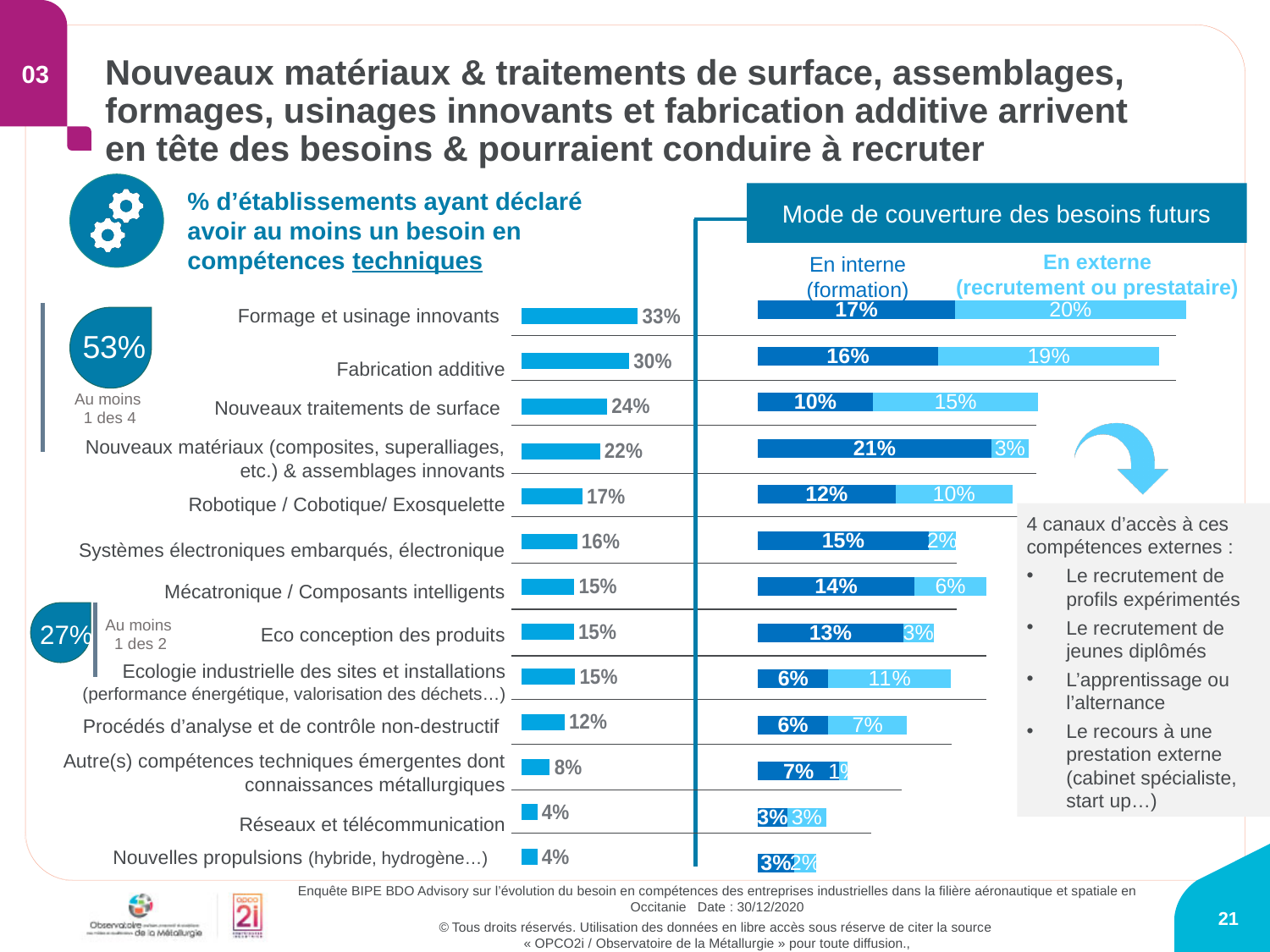
In the left chart '% d'établissements ayant déclaré avoir au moins un besoin en compétences techniques', how many categories are plotted? 13 In the chart 'Mode de couverture des besoins futurs', which series is shown in the darker blue colour? En interne (formation) In the left chart '% d'établissements ayant déclaré avoir au moins un besoin en compétences techniques', what is the difference between Formage et usinage innovants and Nouveaux traitements de surface? 9% In the left chart '% d'établissements ayant déclaré avoir au moins un besoin en compétences techniques', what is the value for Fabrication additive? 30% In the chart 'Mode de couverture des besoins futurs', which is larger for Ecologie industrielle des sites et installations: En interne (formation) or En externe (recrutement ou prestataire)? En externe (recrutement ou prestataire) In the chart 'Mode de couverture des besoins futurs', what is the En externe (recrutement ou prestataire) value for Fabrication additive? 19% In the chart 'Mode de couverture des besoins futurs', what is the En interne (formation) value for Nouveaux matériaux (composites, superalliages, etc.) & assemblages innovants? 21% In the chart 'Mode de couverture des besoins futurs', what is the total of the stacked bar for Formage et usinage innovants? 37% In the left chart '% d'établissements ayant déclaré avoir au moins un besoin en compétences techniques', which category has the highest value? Formage et usinage innovants What kind of chart is 'Mode de couverture des besoins futurs'? Stacked bar chart In the chart 'Mode de couverture des besoins futurs', how many series are shown? 2 In the left chart '% d'établissements ayant déclaré avoir au moins un besoin en compétences techniques', what is the value for Procédés d'analyse et de contrôle non-destructif? 12%